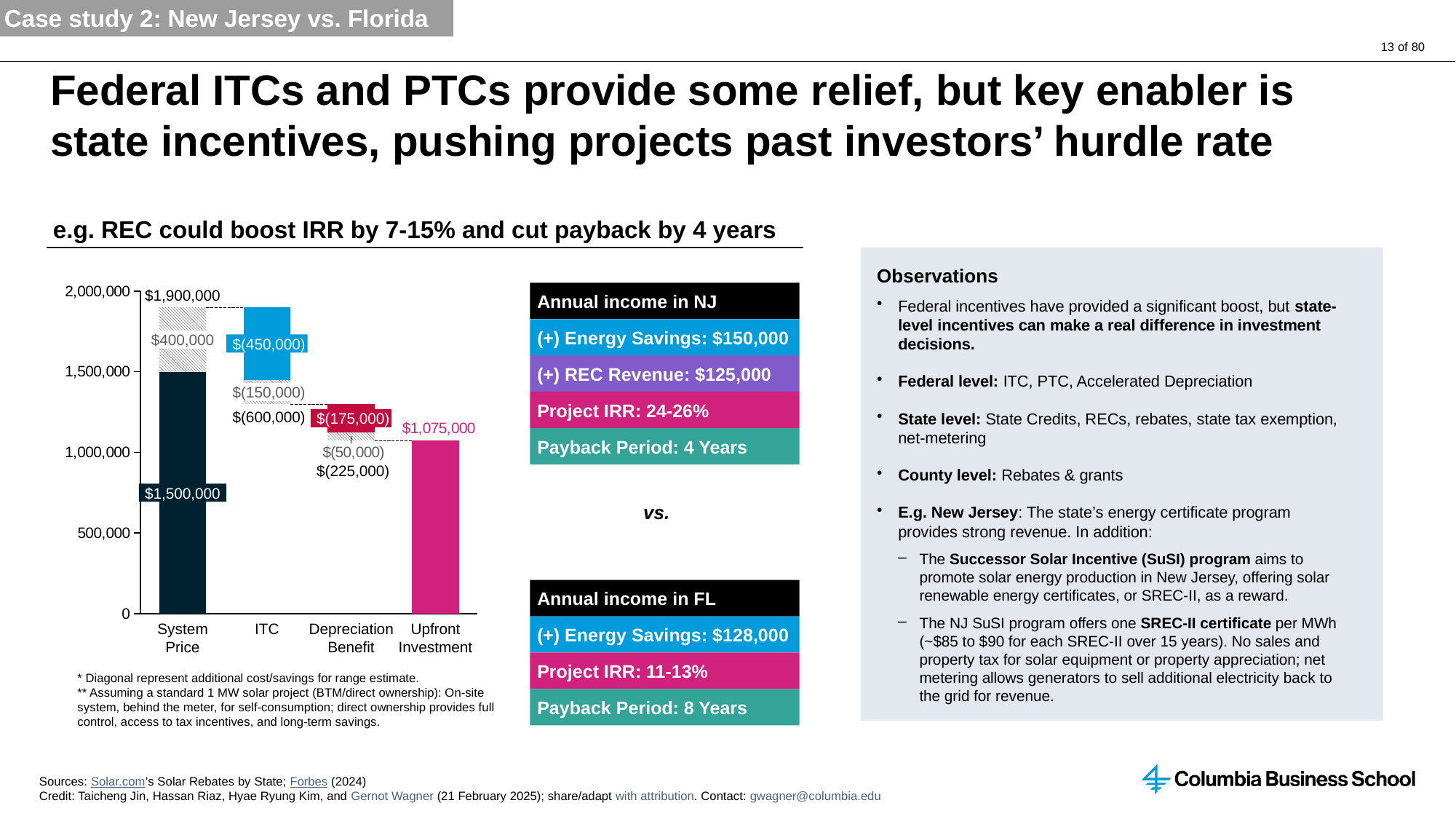
What value is labelled for Upfront Investment in the chart? $1,075,000 What kind of chart is shown on the slide? Bar chart (waterfall) What is the combined Depreciation Benefit value shown below its bar and diagonal range? $(225,000) What is the value labelled on the red Depreciation Benefit bar? $(175,000) What is the value labelled on the blue ITC bar? $(450,000) What is the label at the top of the System Price column, above the diagonal range section? $1,900,000 How many categories are shown on the x axis of the chart? 4 What is the data label on the System Price bar in the waterfall chart? $1,500,000 Which is larger, the System Price bar or the Upfront Investment bar? System Price What is the combined ITC value shown below the ITC bar and its diagonal range? $(600,000) What is the difference between the System Price label ($1,500,000) and the Upfront Investment label ($1,075,000)? $425,000 Is the Upfront Investment bar greater or less than 1,000,000 on the y axis? greater